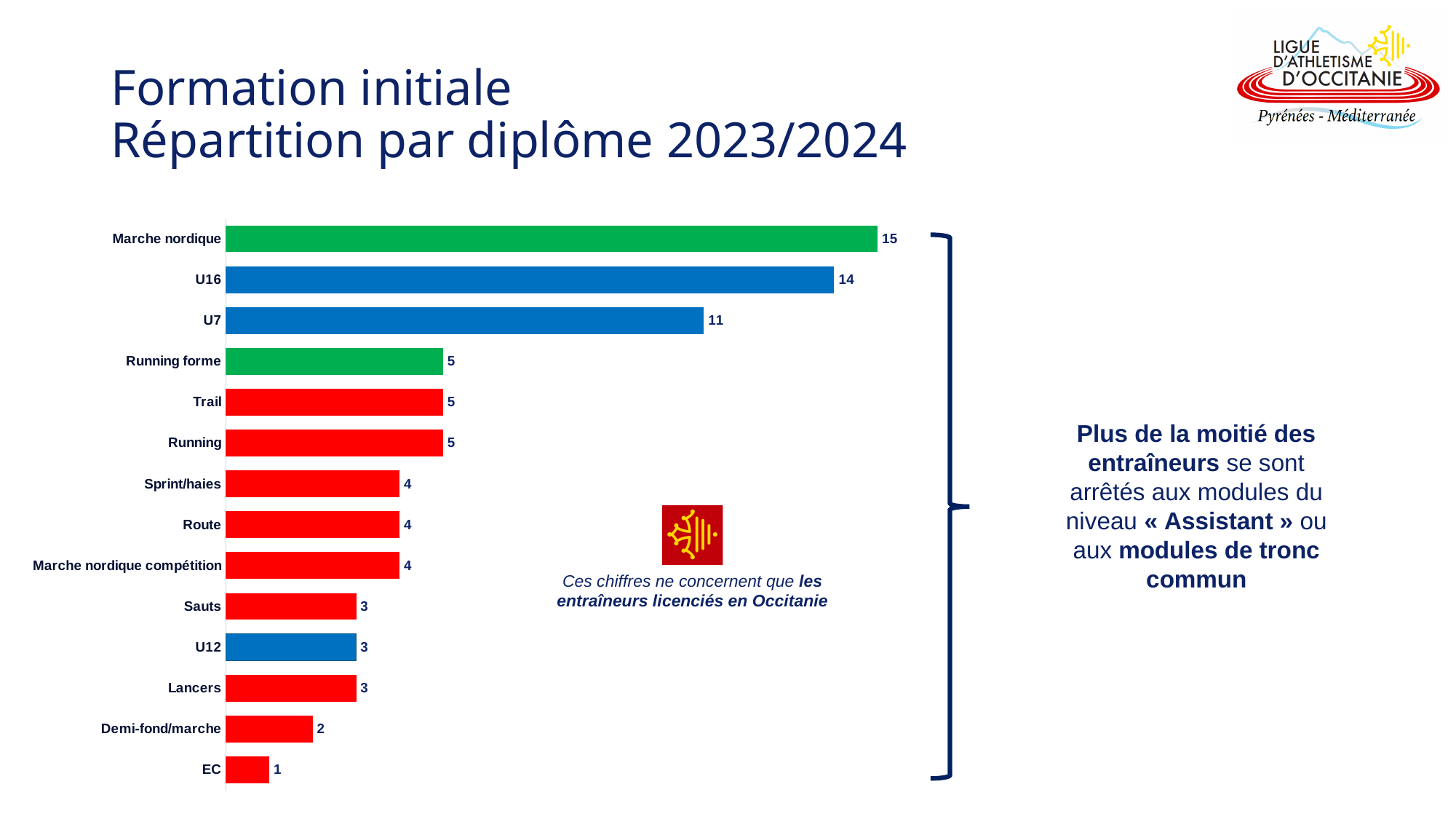
What is the value for Sprint/haies? 4 Which is larger, the value for U16 or the value for U12? U16 What is the difference between the values for Marche nordique and U16? 1 What is the difference between the values for U7 and Running forme? 6 Which category has the highest value? Marche nordique What is the value for U7? 11 What kind of chart is shown on the slide? Bar chart What is the value for Demi-fond/marche? 2 What colour is the bar for Marche nordique? Green How many categories are shown in the chart? 14 Which category has the lowest value? EC What is the value for Marche nordique? 15